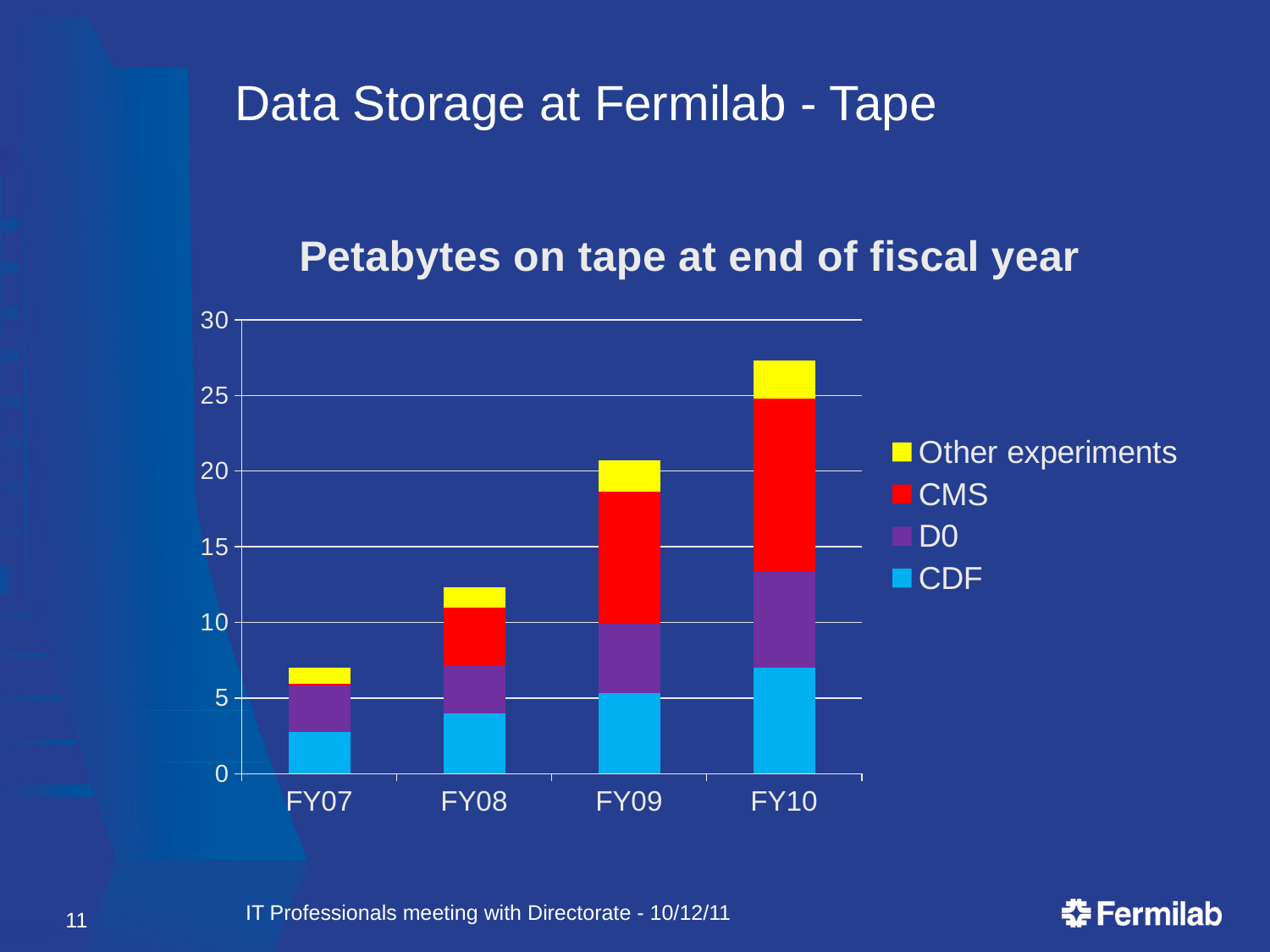
Which is larger, the total for FY09 or the total for FY10? FY10 Which fiscal year has the shortest stacked bar? FY07 How many fiscal years are shown on the x axis of the chart? 4 Which series is shown in red in the chart? CMS Is the CDF value for FY07 greater or less than 5? less Is the total value for FY10 greater or less than 25? greater Is the total value for FY08 greater or less than 10? greater Which fiscal year has the tallest stacked bar? FY10 What kind of chart is shown on the slide? stacked bar chart Do the total petabytes on tape rise or fall from FY07 to FY10? rise What is the title of the chart? Petabytes on tape at end of fiscal year How many series does the legend list? 4